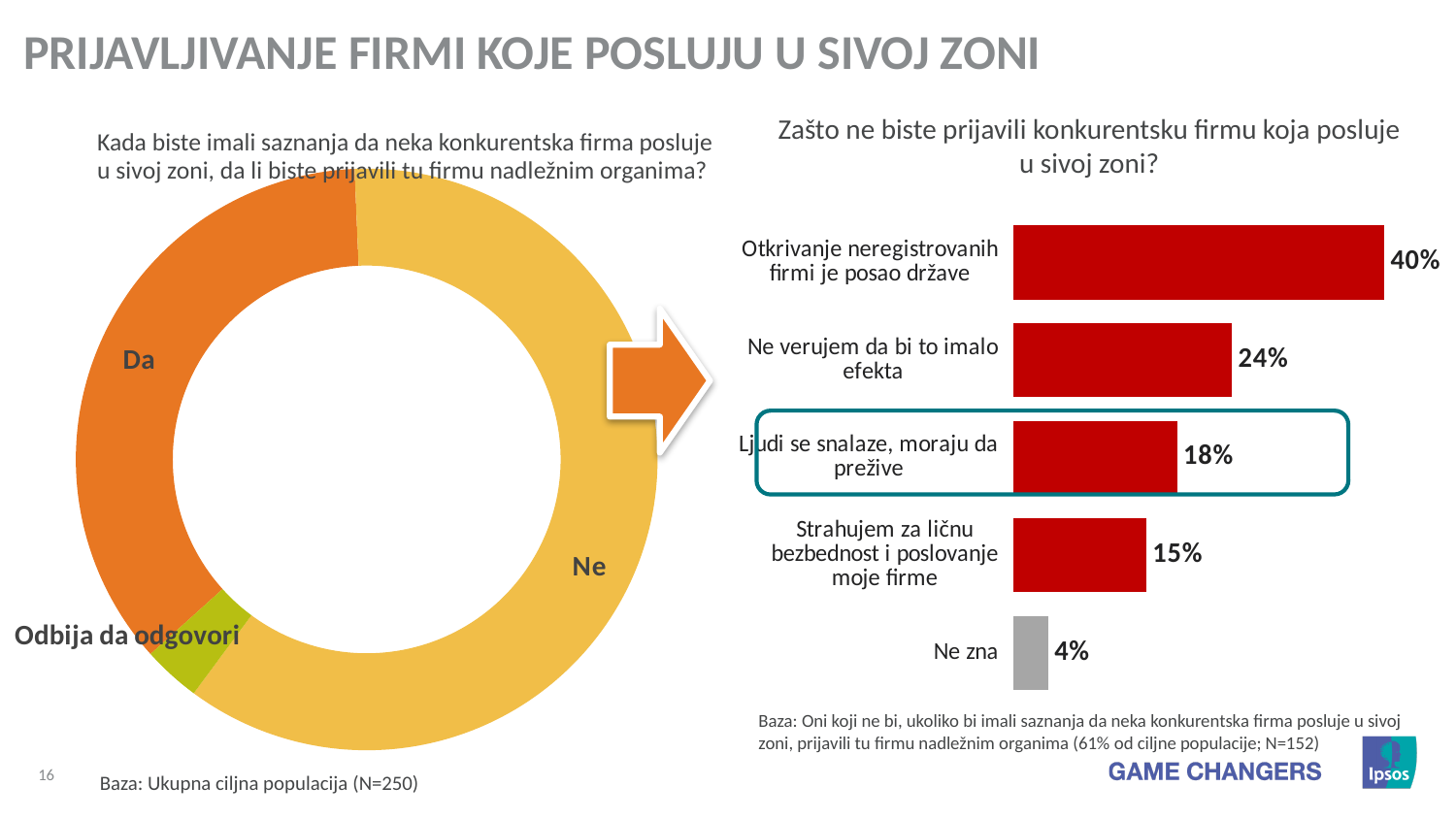
What kind of chart is on the left side of the slide? Donut chart In the chart on the right, what percentage is shown for "Ljudi se snalaze, moraju da prežive"? 18% In the chart on the right, what percentage is shown for "Ne verujem da bi to imalo efekta"? 24% In the donut chart on the left, which answer has the smallest share? Odbija da odgovori How many categories are shown in the bar chart on the right? 5 In the chart on the right, what percentage is shown for "Otkrivanje neregistrovanih firmi je posao države"? 40% In the chart on the right, which reason has the highest percentage? Otkrivanje neregistrovanih firmi je posao države In the chart on the right, what is the difference between "Otkrivanje neregistrovanih firmi je posao države" and "Ne verujem da bi to imalo efekta"? 16% In the chart on the right, what percentage is shown for "Ne zna"? 4% In the chart on the right, which is larger: "Ljudi se snalaze, moraju da prežive" or "Strahujem za ličnu bezbednost i poslovanje moje firme"? Ljudi se snalaze, moraju da prežive In the donut chart on the left, which answer has the largest share? Ne In the chart on the right, which category has the lowest percentage? Ne zna